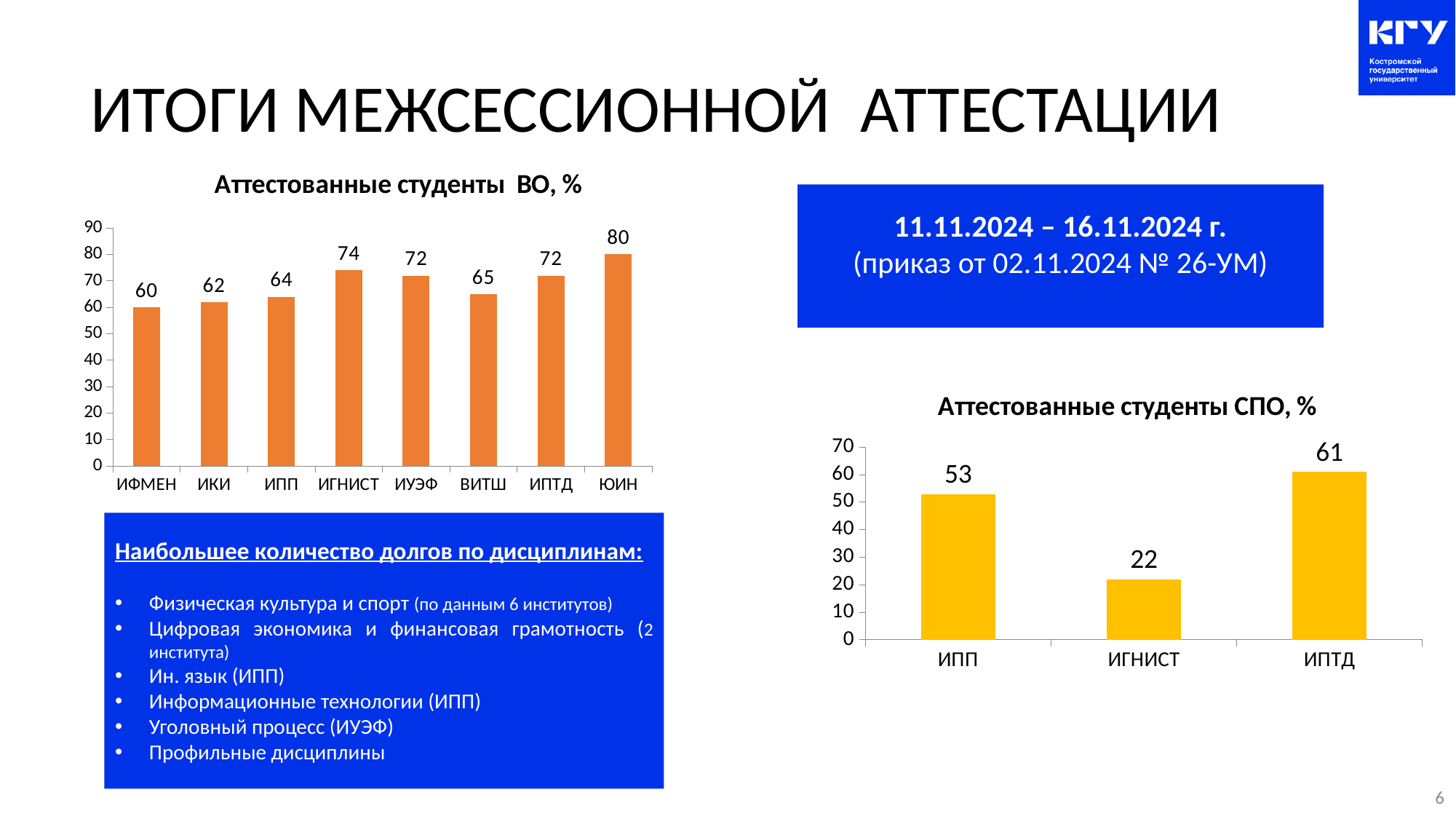
In the chart 'Аттестованные студенты ВО, %', what is the value for ИГНИСТ? 74 In the chart 'Аттестованные студенты СПО, %', what is the difference between the values for ИПТД and ИПП? 8 In the chart 'Аттестованные студенты ВО, %', what is the difference between the values for ЮИН and ИФМЕН? 20 How many categories are shown in the chart 'Аттестованные студенты СПО, %'? 3 In the chart 'Аттестованные студенты ВО, %', which is larger, the value for ИПП or the value for ВИТШ? ВИТШ In the chart 'Аттестованные студенты СПО, %', what is the value for ИГНИСТ? 22 In the chart 'Аттестованные студенты СПО, %', which category has the highest value? ИПТД How many categories are shown in the chart 'Аттестованные студенты ВО, %'? 8 In the chart 'Аттестованные студенты ВО, %', which category has the lowest value? ИФМЕН In the chart 'Аттестованные студенты ВО, %', which category has the highest value? ЮИН What kind of chart is 'Аттестованные студенты СПО, %'? Bar chart What colour are the bars in the chart 'Аттестованные студенты СПО, %'? Yellow